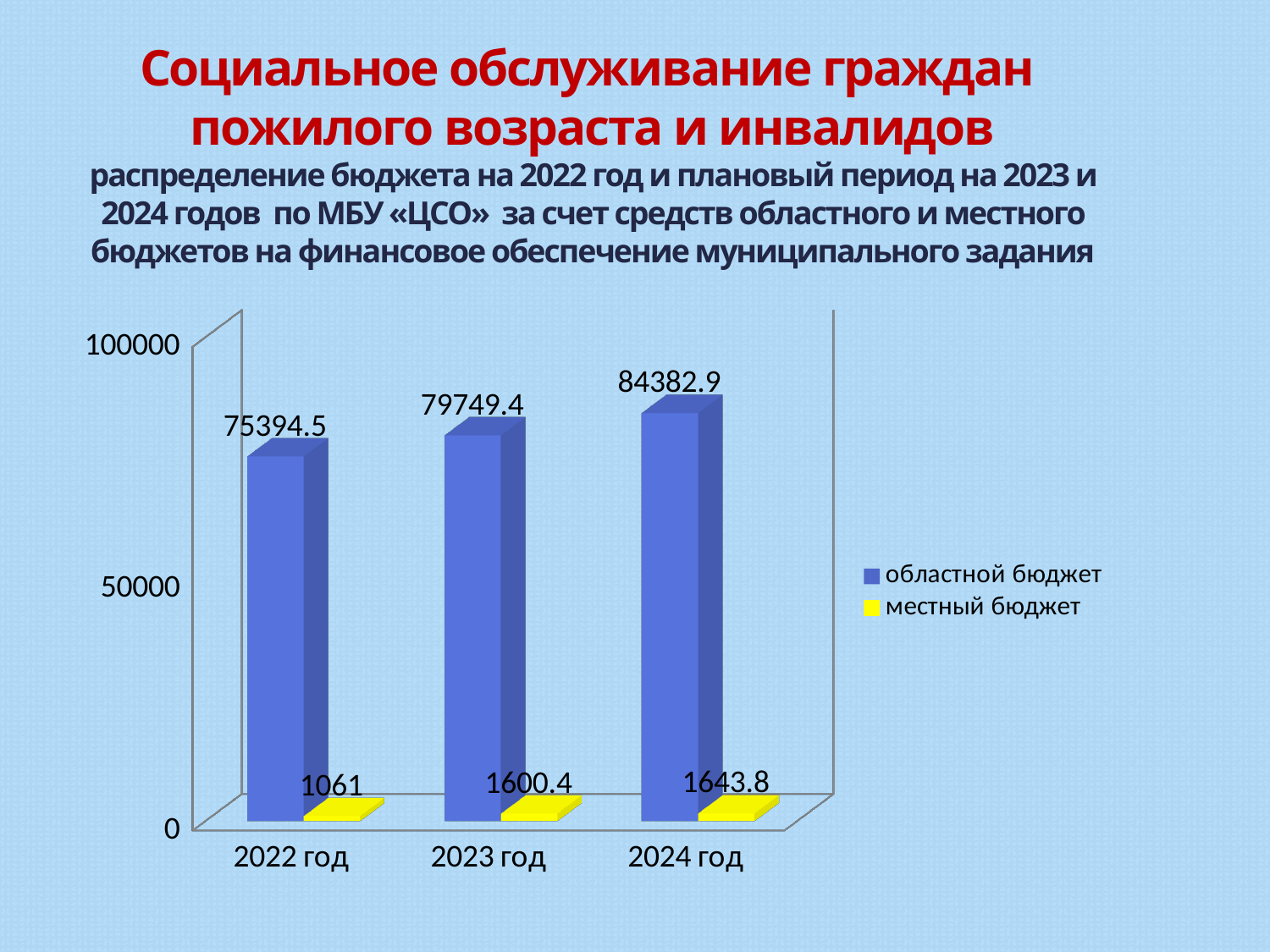
Which is larger: областной бюджет in 2023 год or областной бюджет in 2022 год? областной бюджет in 2023 год What is the value of областной бюджет for 2024 год? 84382.9 Does областной бюджет rise or fall from 2022 год to 2024 год? rise How many series does the legend list? 2 In which year is местный бюджет the lowest? 2022 год In which year is областной бюджет the highest? 2024 год What is the difference between областной бюджет in 2024 год and in 2022 год? 8988.4 What is the value of местный бюджет for 2023 год? 1600.4 Is the value of областной бюджет for 2023 год greater or less than 50000? greater What is the value of местный бюджет for 2022 год? 1061 What is the value of областной бюджет for 2022 год? 75394.5 What is the difference between местный бюджет in 2024 год and in 2022 год? 582.8